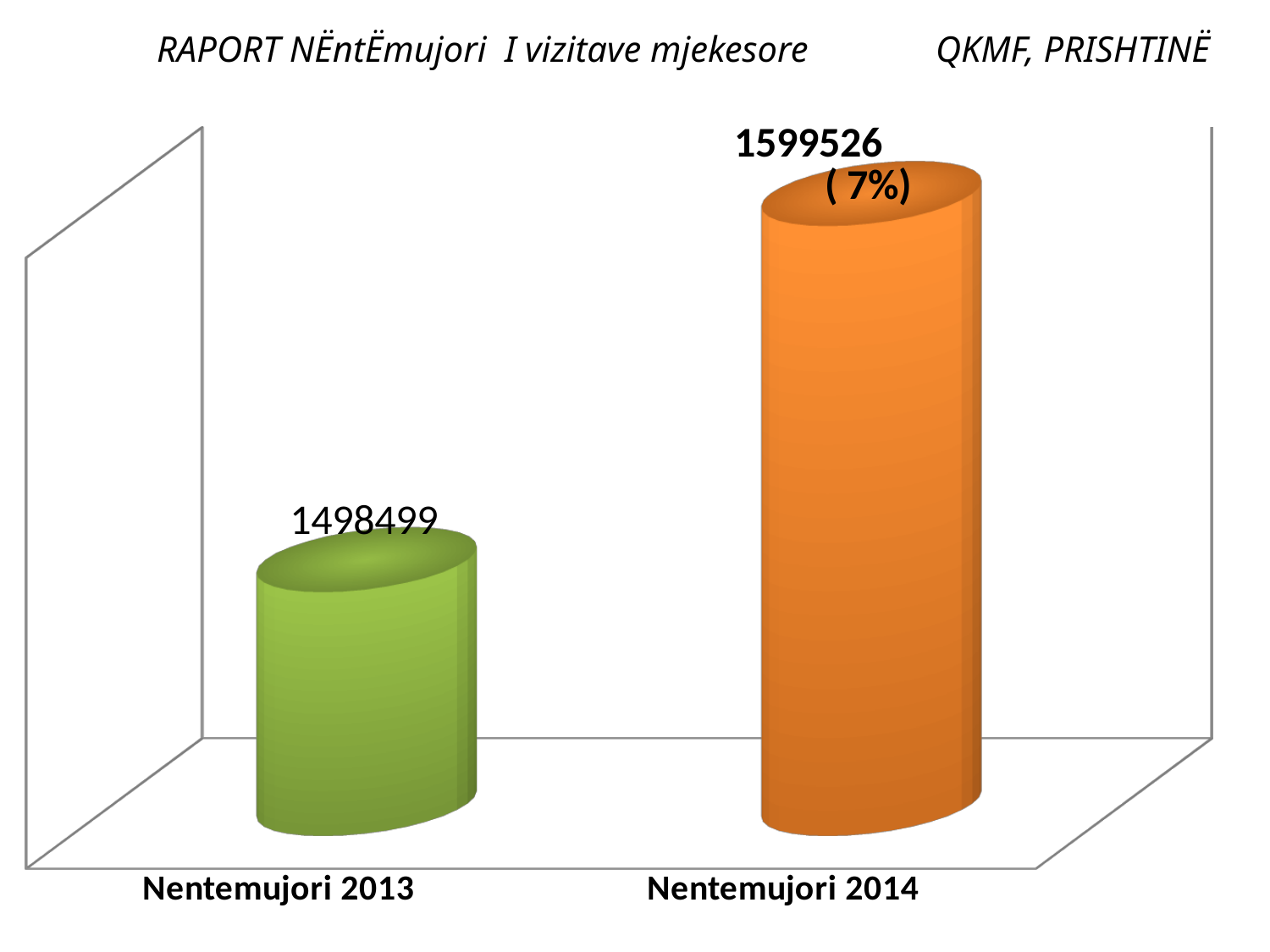
Which category has the highest value? Nentemujori 2014 Do the values rise or fall from Nentemujori 2013 to Nentemujori 2014? Rise What is the difference between the values for Nentemujori 2014 and Nentemujori 2013? 101027 What colour is the bar for Nentemujori 2013? Green Which is larger, the value for Nentemujori 2013 or Nentemujori 2014? Nentemujori 2014 How many categories are shown in the chart? 2 What kind of chart is shown on the slide? Bar chart Which category has the lowest value? Nentemujori 2013 What is the value for Nentemujori 2013? 1498499 What percentage is printed next to the value for Nentemujori 2014? 7% What is the value for Nentemujori 2014? 1599526